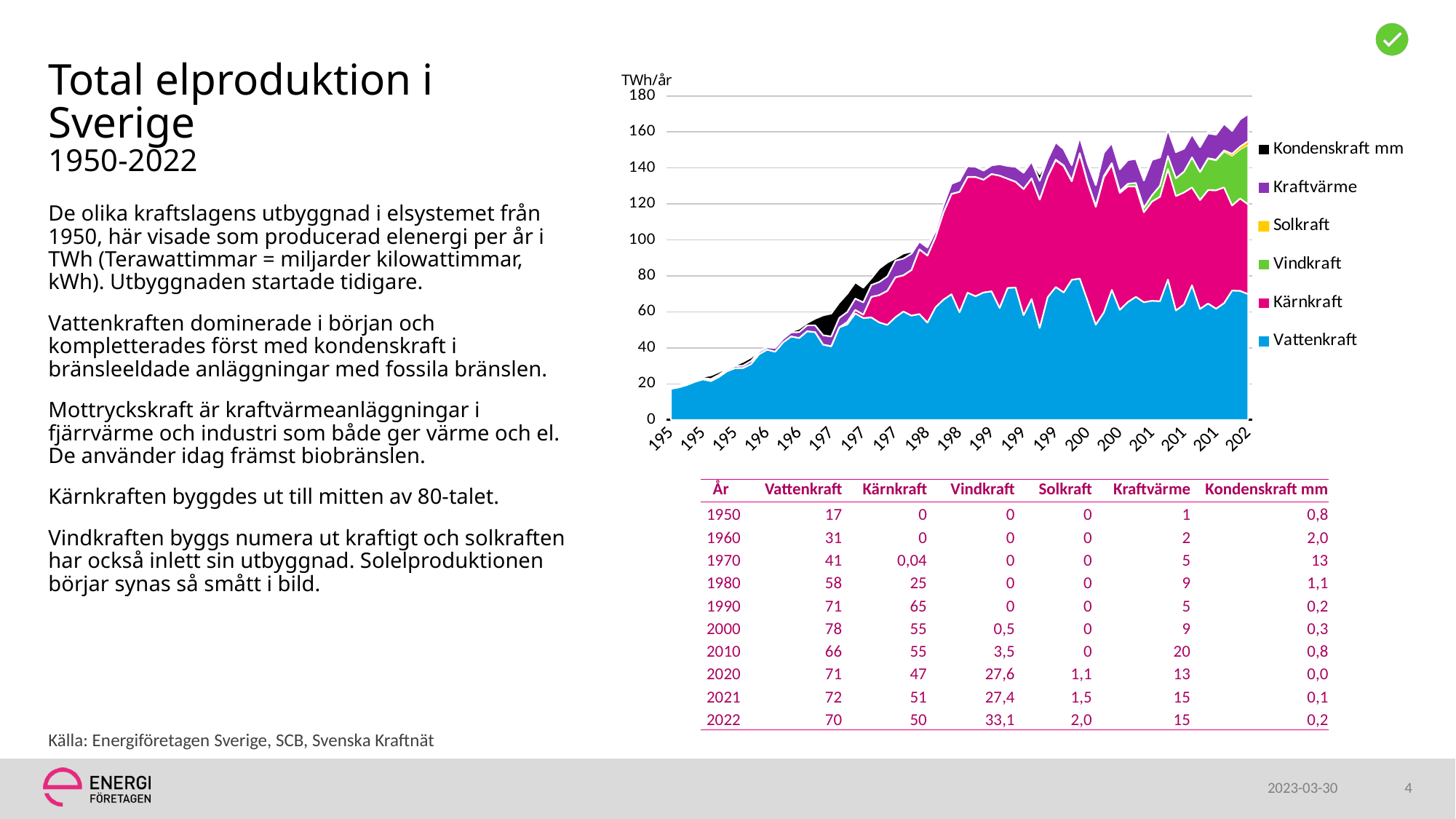
According to the table, what was the Kondenskraft mm value in 1970? 13 In 1990, which was larger, Vattenkraft or Kärnkraft? Vattenkraft What kind of chart is shown on the slide? Stacked area chart Is the total electricity production in 2022 greater or less than 160 TWh/år? greater Is the value for Vattenkraft in 1950 greater or less than 20 TWh/år? less Does Vattenkraft rise or fall from 1950 to 1980 in the chart? rise By how much did Vindkraft increase from 2021 to 2022 according to the table? 5,7 According to the table, what was the Vindkraft value in 2022? 33,1 How many series does the chart's legend list? 6 What unit is shown on the chart's vertical axis? TWh/år According to the table, what was the Vattenkraft value in 1990? 71 Which series is shown in green in the chart? Vindkraft